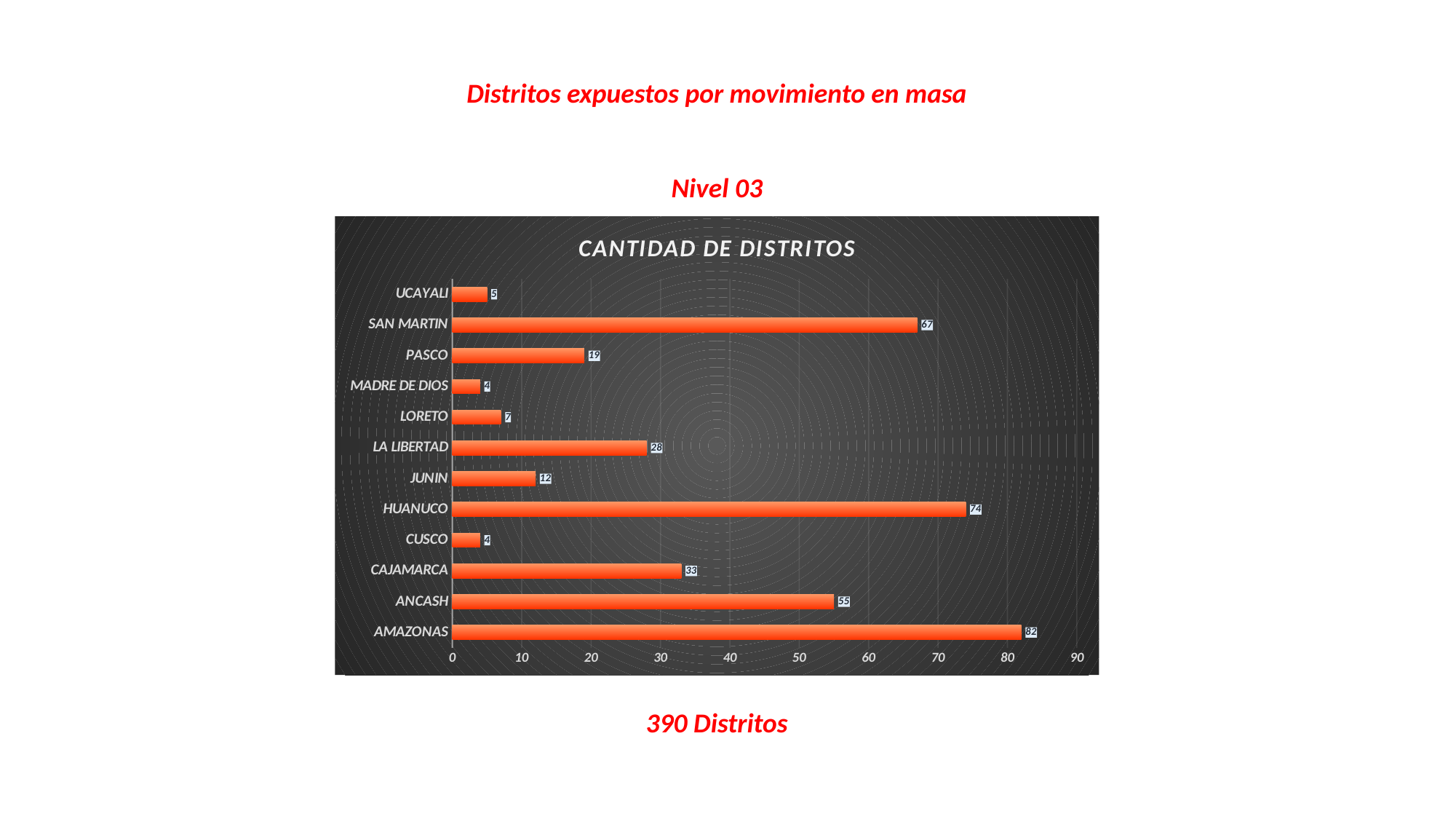
Which is larger, the value for CAJAMARCA or the value for PASCO? CAJAMARCA Is the value for ANCASH greater or less than 50? greater What is the difference between the values for AMAZONAS and ANCASH? 27 What is the title of the chart? CANTIDAD DE DISTRITOS Which category has the highest value? AMAZONAS How many categories are shown in the chart? 12 What is the value for JUNIN? 12 What is the difference between the values for HUANUCO and SAN MARTIN? 7 What is the value for HUANUCO? 74 What kind of chart is shown on the slide? bar chart What is the value for SAN MARTIN? 67 What is the value for LA LIBERTAD? 28